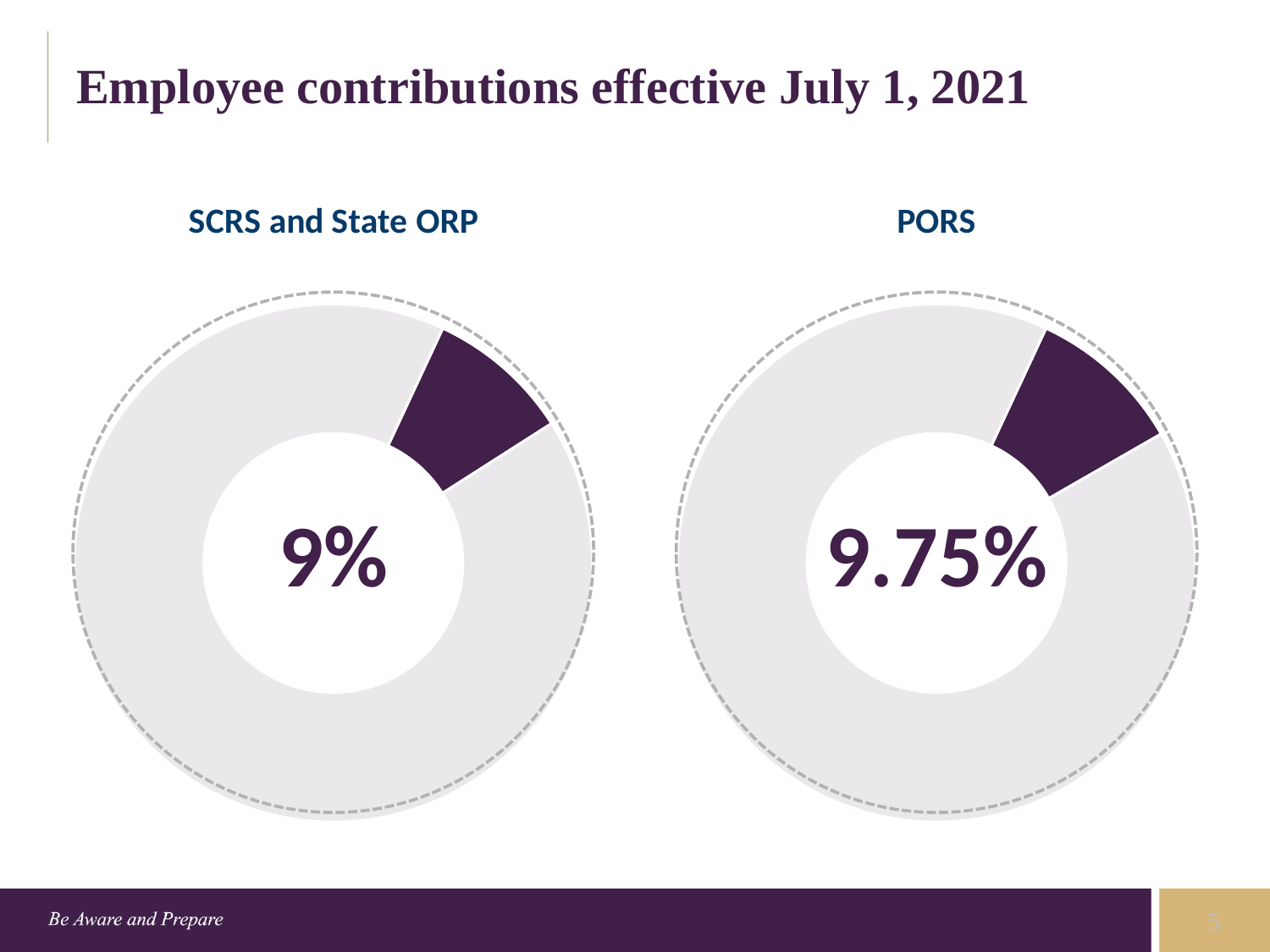
In the PORS chart, what employee contribution rate is shown? 9.75% How many charts are shown on the slide? 2 What is the label above the left-hand chart? SCRS and State ORP Which chart shows the higher employee contribution rate, SCRS and State ORP or PORS? PORS What kind of chart is used for the PORS figure? Donut (pie) chart What kind of chart is used for the SCRS and State ORP figure? Donut (pie) chart In the SCRS and State ORP chart, what share of the donut does the dark purple slice represent? 9% What is the title of the slide containing the two charts? Employee contributions effective July 1, 2021 In the SCRS and State ORP chart, what employee contribution rate is shown? 9% In the PORS chart, what share of the donut does the dark purple slice represent? 9.75% What is the difference between the PORS rate and the SCRS and State ORP rate? 0.75%